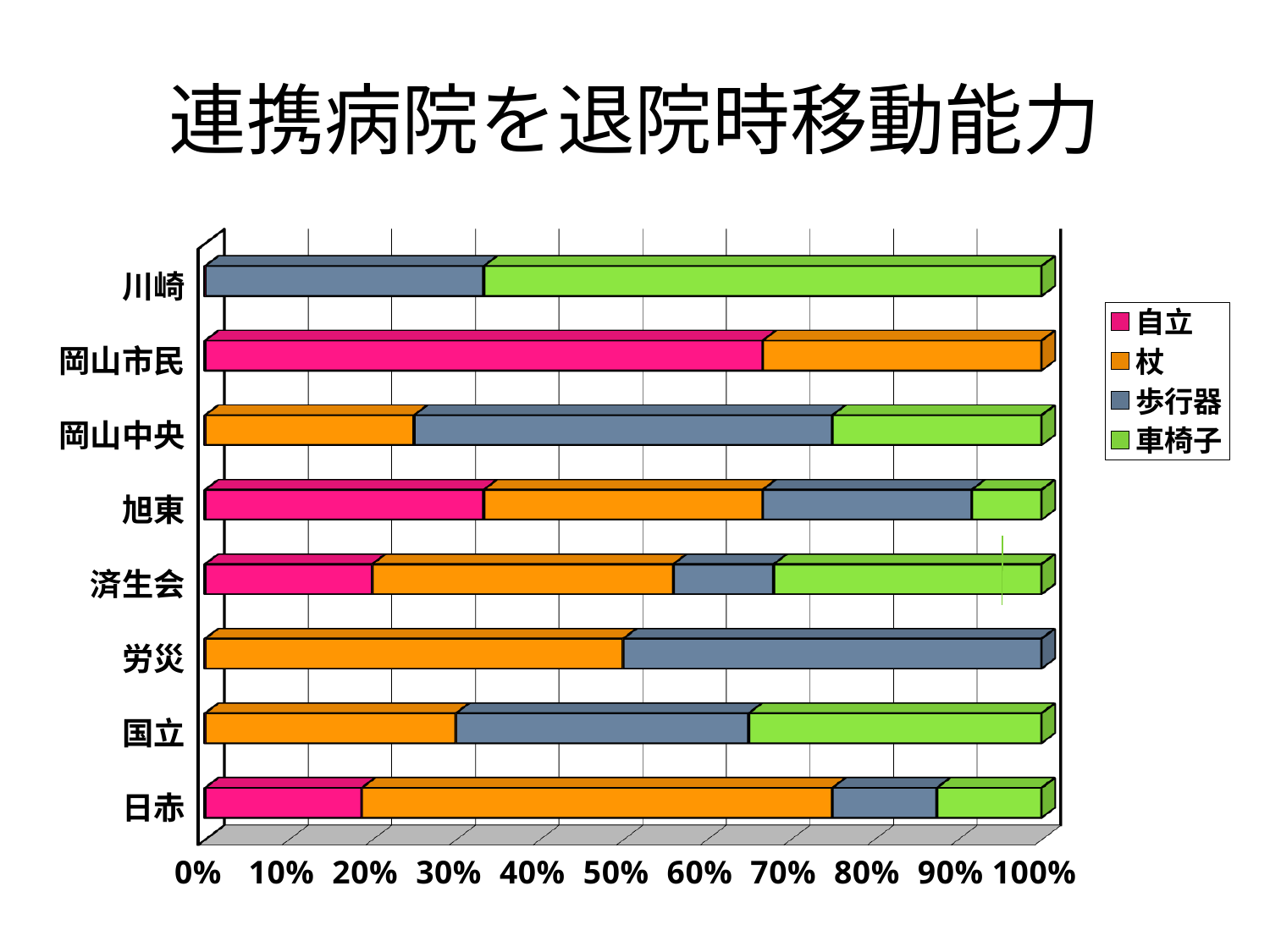
How many hospitals (categories) are shown on the y axis? 8 Is the 自立 share for 岡山市民 greater or less than 60%? greater How many hospitals have a 自立 segment in their bar? 4 Which has the larger 杖 share, 労災 or 国立? 労災 What is the title of the chart? 連携病院を退院時移動能力 Which series is shown in green in the legend? 車椅子 How many series does the legend list? 4 Is the 自立 share for 日赤 greater or less than 30%? less What kind of chart is shown on the slide? stacked bar chart Which hospital has the largest 自立 share? 岡山市民 What is the total of the 川崎 bar? 100% Is the 歩行器 share for 川崎 greater or less than 40%? less